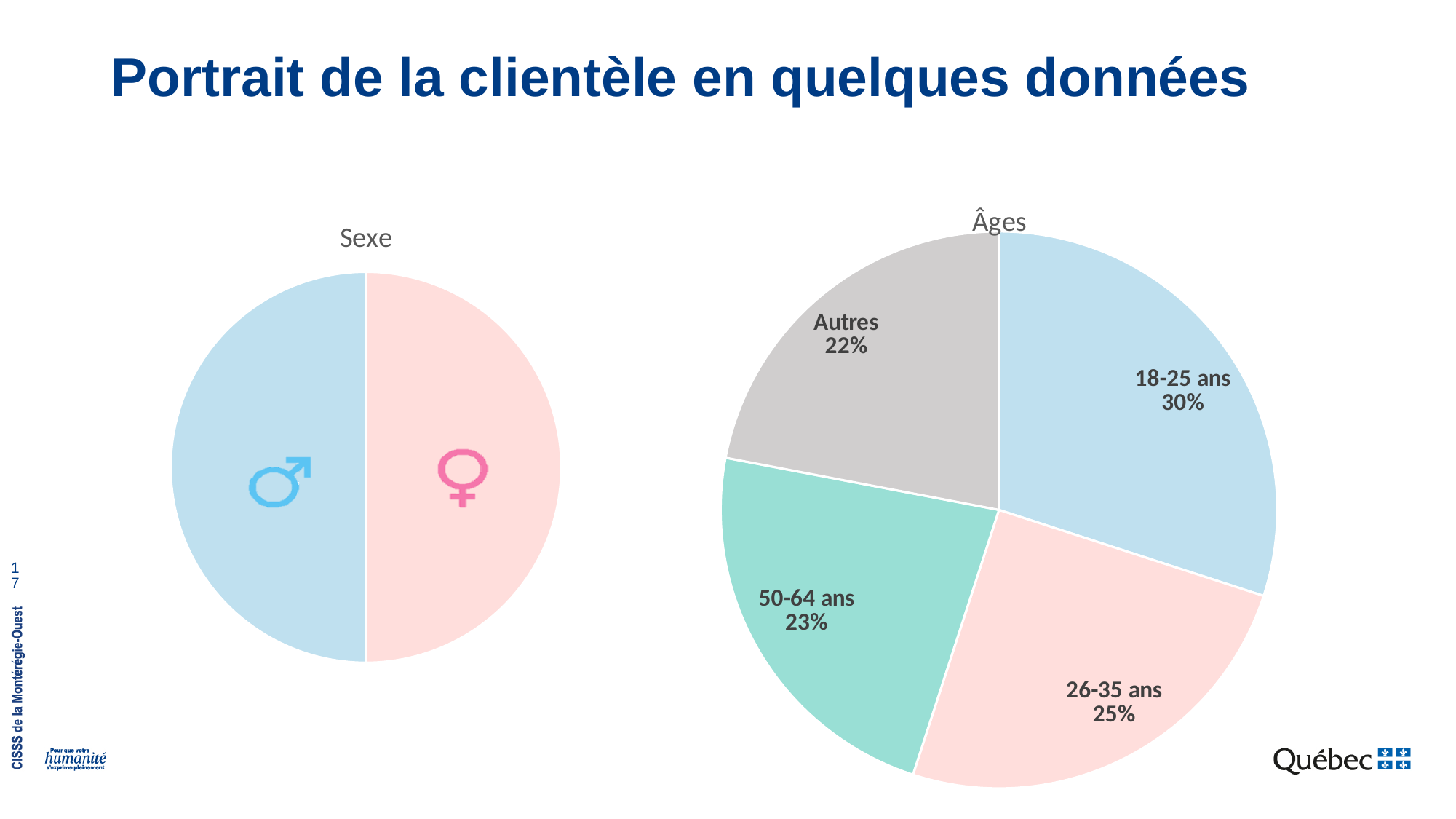
In the 'Âges' chart, what percentage is shown for 26-35 ans? 25% In the 'Âges' chart, which slice has the smallest share? Autres In the 'Âges' chart, what is the difference in percentage points between 18-25 ans and 26-35 ans? 5 In the 'Âges' chart, what percentage is shown for 50-64 ans? 23% What is the title of the chart on the right side of the slide? Âges In the 'Âges' chart, which is larger: 50-64 ans or Autres? 50-64 ans In the 'Âges' chart, what share is labelled 'Autres'? 22% What type of chart is the 'Sexe' chart? Pie chart In the 'Âges' chart, what share of the clientele is 18-25 ans? 30% How many slices does the 'Sexe' pie chart have? 2 How many slices does the 'Âges' pie chart have? 4 In the 'Âges' chart, which age group has the largest share? 18-25 ans